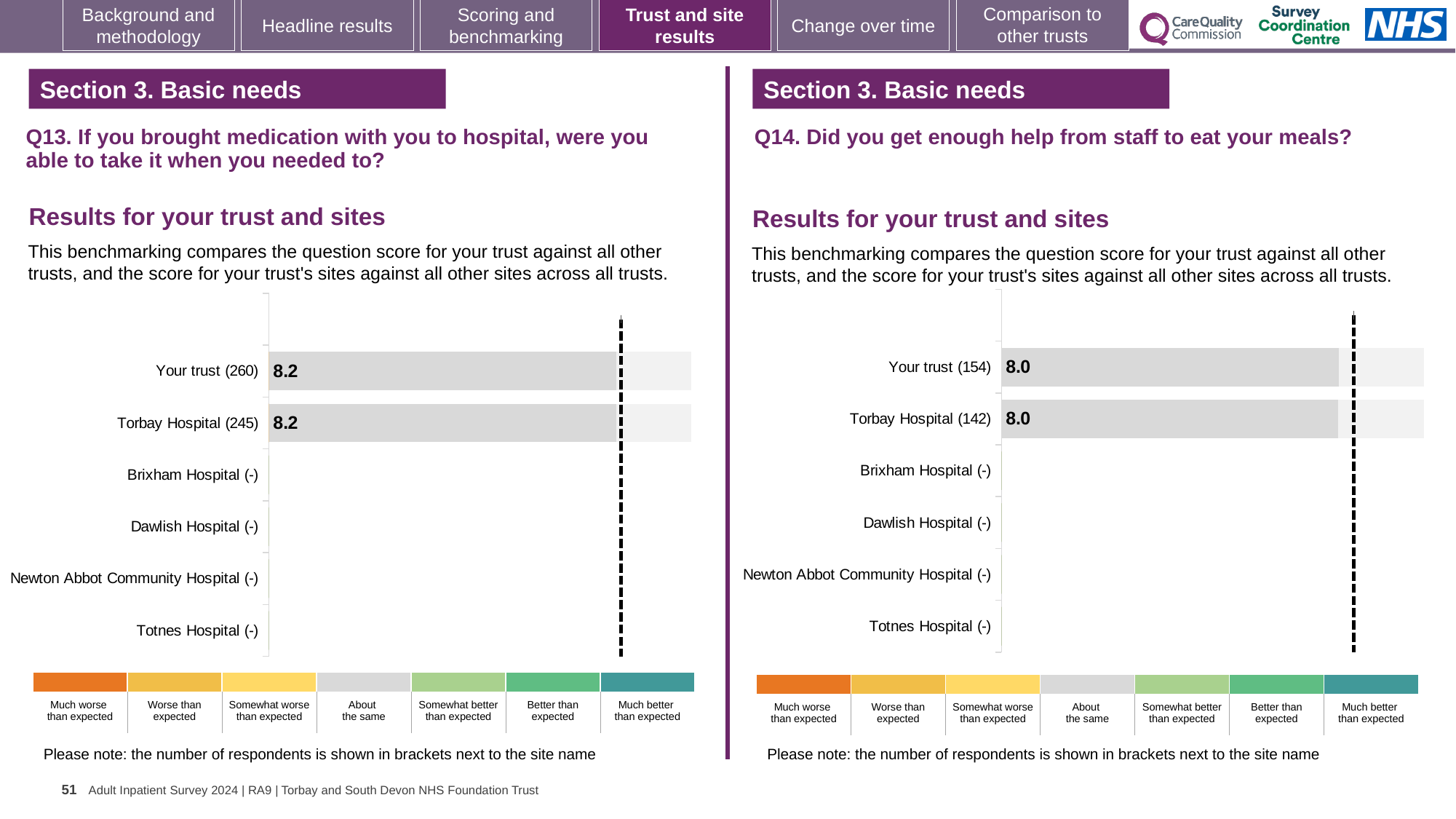
On the Q13 chart (left), what is the score for Your trust? 8.2 On the Q13 chart (left), how many respondents are shown in brackets for Your trust? 260 On the Q14 chart (right), which benchmark category does the colour band legend list first (leftmost)? Much worse than expected On the Q13 chart (left), how many sites show no score (a dash in brackets)? 4 On the Q14 chart (right), what is the score for Your trust? 8.0 On the Q13 chart (left), what is the difference between the score for Your trust and the score for Torbay Hospital? 0.0 On the Q14 chart (right), what is the score for Torbay Hospital? 8.0 On the Q13 chart (left), what is the score for Torbay Hospital? 8.2 On the Q14 chart (right), how many site or trust categories are listed on the vertical axis? 6 On the Q14 chart (right), how many respondents are shown in brackets for Torbay Hospital? 142 Is the score for Your trust on the Q13 chart (left) larger than the score for Your trust on the Q14 chart (right)? Yes What type of chart is used on the Q13 chart (left)? Bar chart